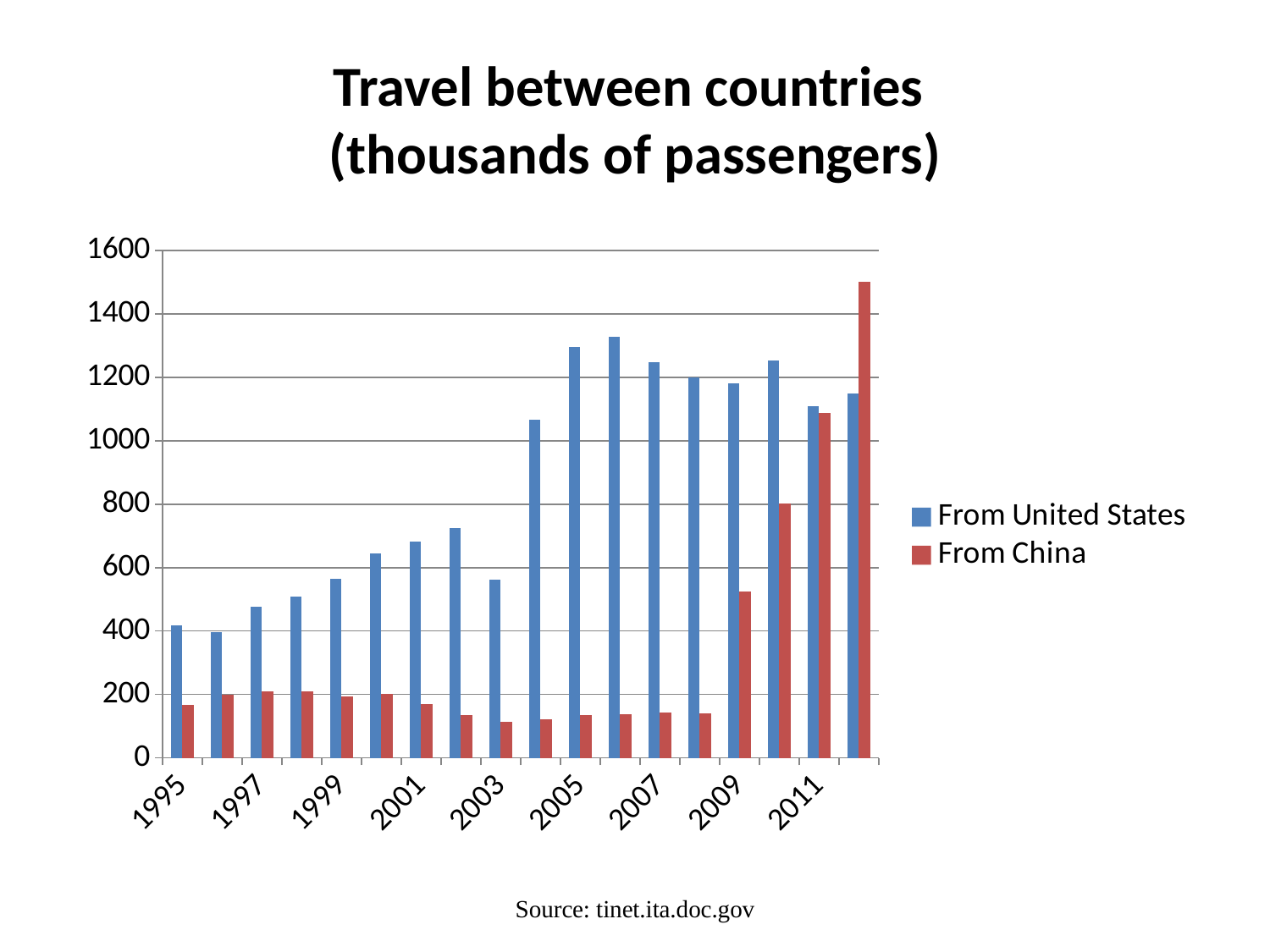
Is the value for From China in 2009 greater or less than 400? greater How many series does the legend list? 2 What is the title of the chart? Travel between countries (thousands of passengers) In 2005, which series has the larger value, From United States or From China? From United States In which year is the From China value highest? 2012 Is the value for From United States in 1995 greater or less than 600? less What are the two series named in the legend? From United States and From China Is the value for From China in 2012 greater or less than 1400? greater In 2012, which series has the larger value, From United States or From China? From China Do the From China values rise or fall from 2009 to 2012? rise What kind of chart is shown on the slide? bar chart